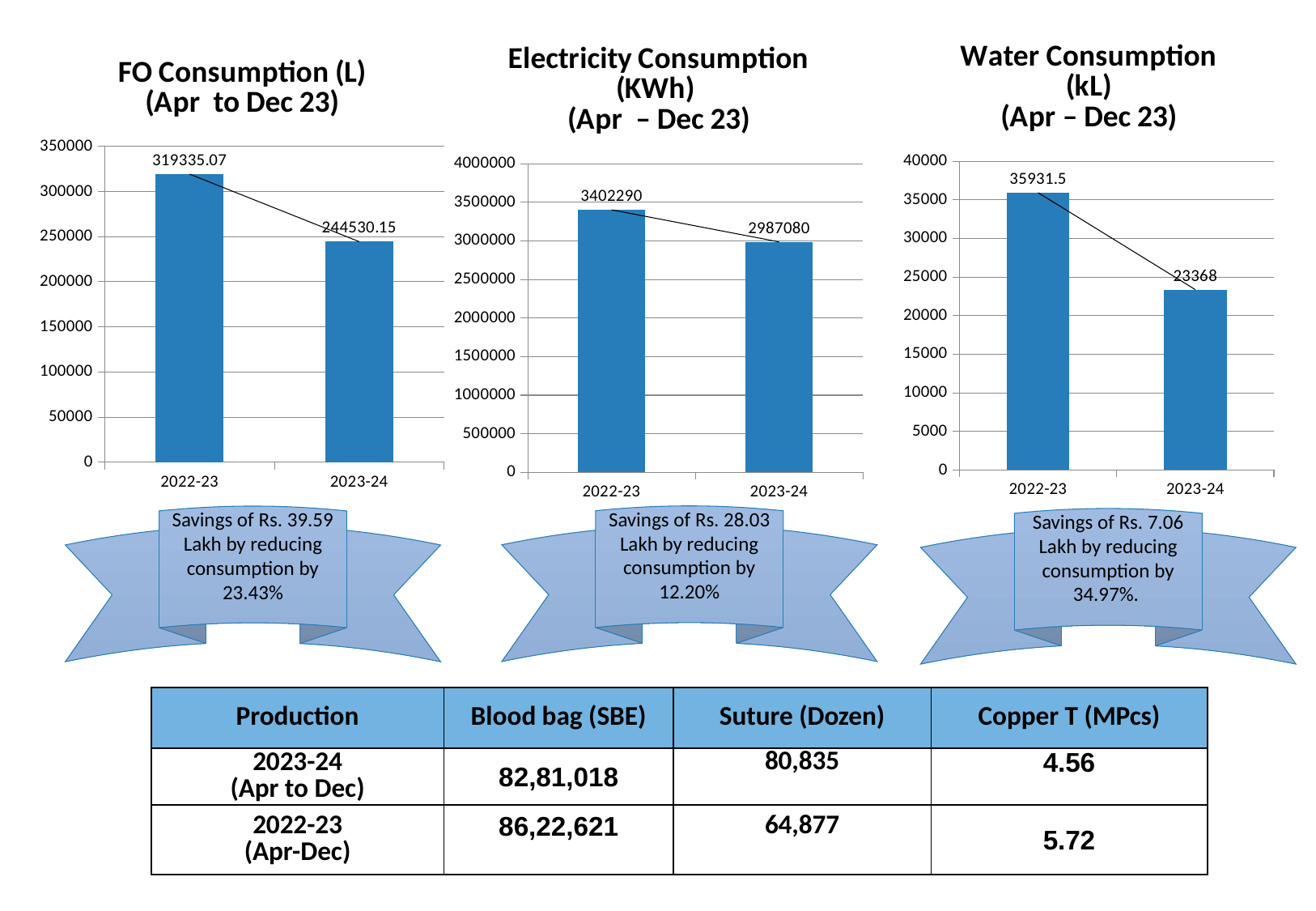
In the FO Consumption (L) chart, what is the value for 2022-23? 319335.07 In the Water Consumption (kL) chart, is the value for 2023-24 greater or less than 25000? less In the Water Consumption (kL) chart, which year has the lowest value? 2023-24 In the FO Consumption (L) chart, what is the difference between the 2022-23 and 2023-24 values? 74804.92 How many categories are shown on the x axis of the FO Consumption (L) chart? 2 What type of chart is the Electricity Consumption (KWh) chart? bar chart In the Electricity Consumption (KWh) chart, what is the difference between the 2022-23 and 2023-24 values? 415210 In the FO Consumption (L) chart, what is the value for 2023-24? 244530.15 In the Water Consumption (kL) chart, do the values rise or fall from 2022-23 to 2023-24? fall In the Electricity Consumption (KWh) chart, which year has the higher value? 2022-23 In the Electricity Consumption (KWh) chart, what is the value for 2023-24? 2987080 In the Water Consumption (kL) chart, what is the value for 2022-23? 35931.5